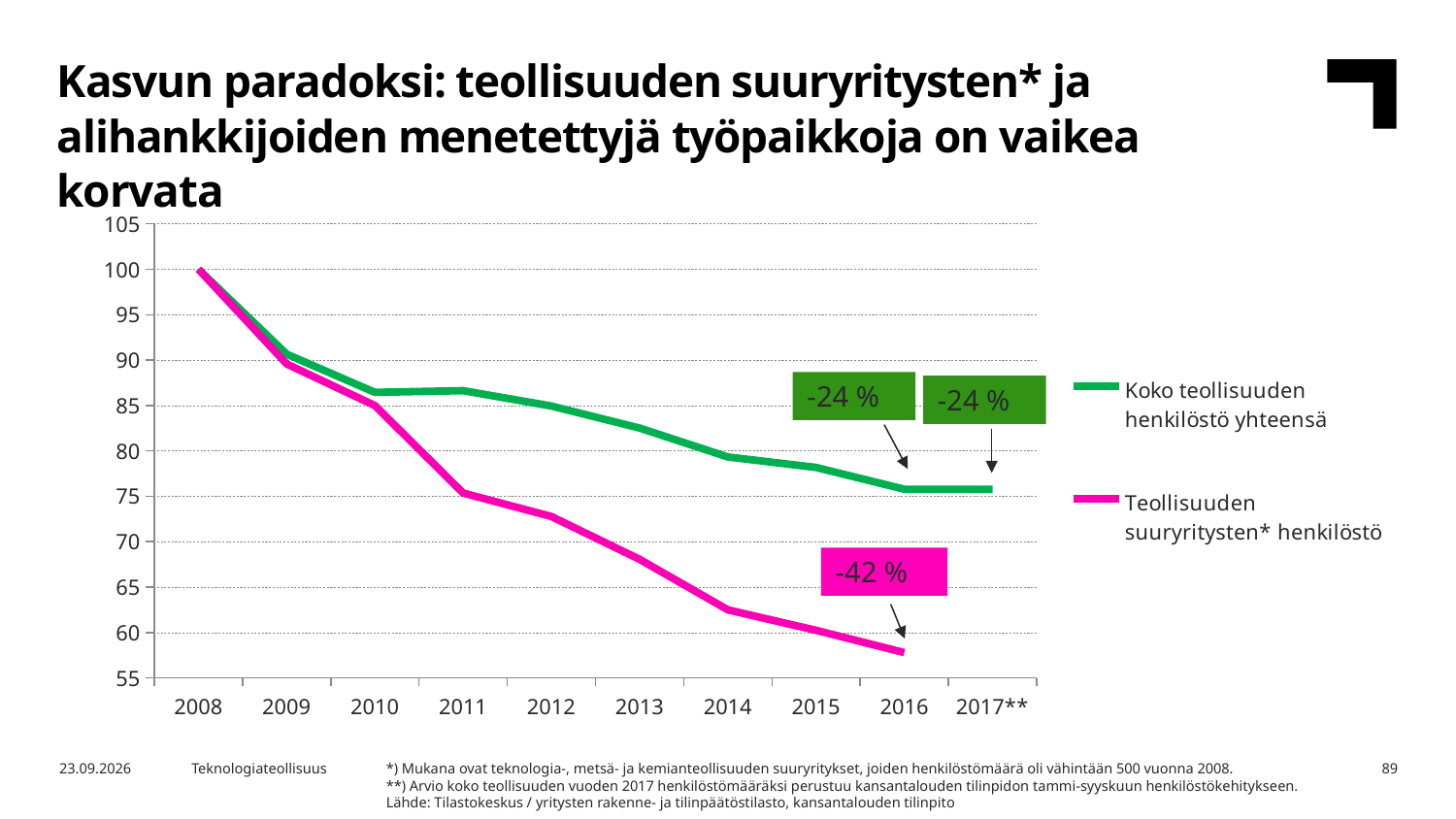
Do the values of the Teollisuuden suuryritysten* henkilöstö series rise or fall from 2008 to 2016? fall Is the value for Teollisuuden suuryritysten* henkilöstö in 2012 greater or less than 70? greater What percentage change is annotated for the Teollisuuden suuryritysten* henkilöstö series in 2016? -42 % Is the value for Koko teollisuuden henkilöstö yhteensä in 2016 greater or less than 80? less In which year is the Teollisuuden suuryritysten* henkilöstö series at its lowest? 2016 Which series has the higher value in 2016? Koko teollisuuden henkilöstö yhteensä How many series does the legend list? 2 What percentage change is annotated for the Koko teollisuuden henkilöstö yhteensä series at 2017**? -24 % What is the value of the Koko teollisuuden henkilöstö yhteensä series in 2008? 100 Is the value for Teollisuuden suuryritysten* henkilöstö in 2016 greater or less than 60? less What kind of chart is shown on the slide? line chart How many years are shown on the x axis? 10